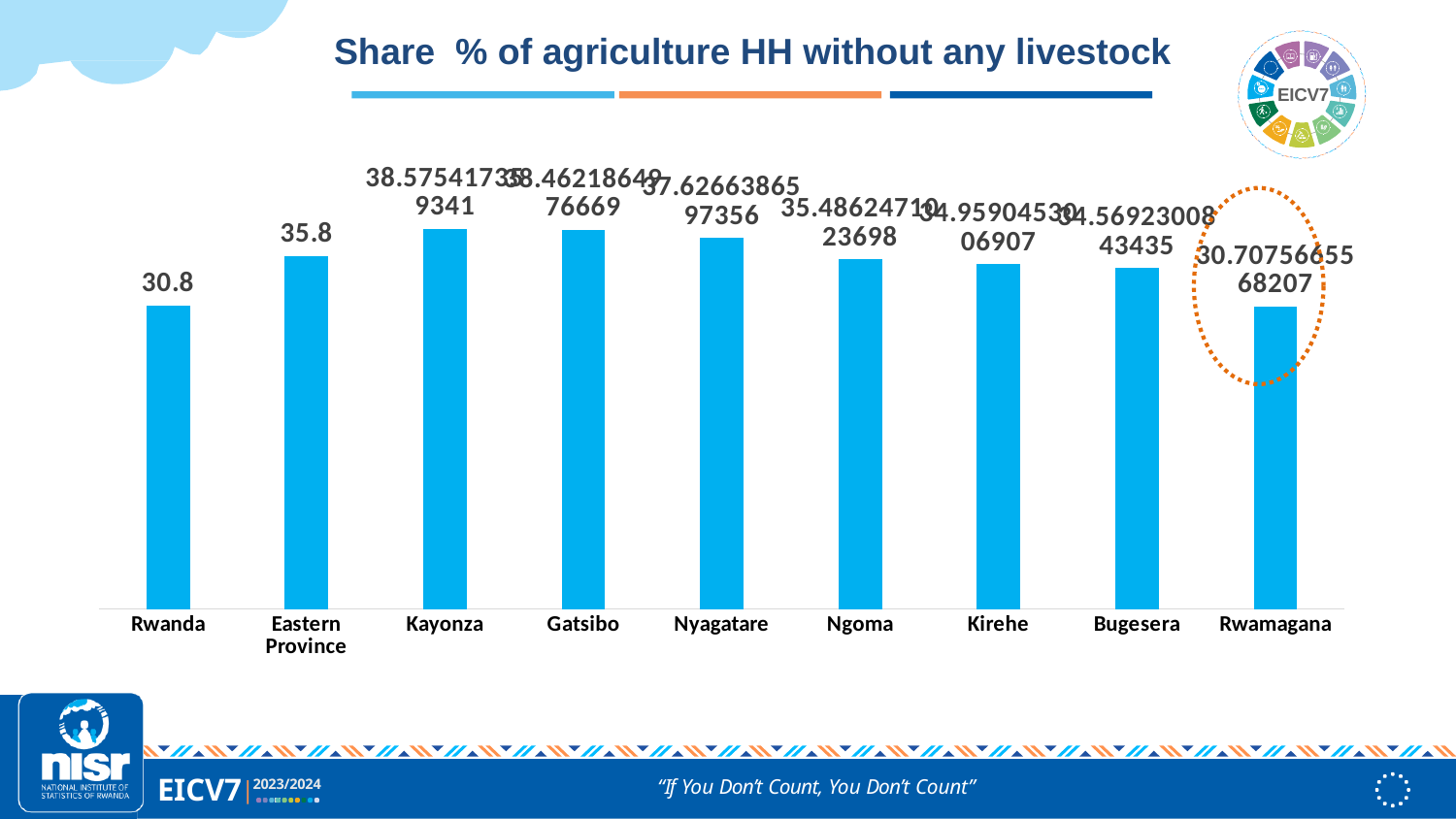
How many categories are shown on the x axis? 9 Which is larger, the value for Gatsibo or the value for Kirehe? Gatsibo What is the value for Rwanda? 30.8 Which is larger, the value for Eastern Province or the value for Rwanda? Eastern Province Which is larger, the value for Kayonza or the value for Rwamagana? Kayonza What is the difference between the values for Eastern Province and Rwanda? 5 What is the value for Eastern Province? 35.8 What is the title of the chart? Share % of agriculture HH without any livestock What kind of chart is shown on the slide? Bar chart Which category's bar is highlighted with a dotted circle? Rwamagana